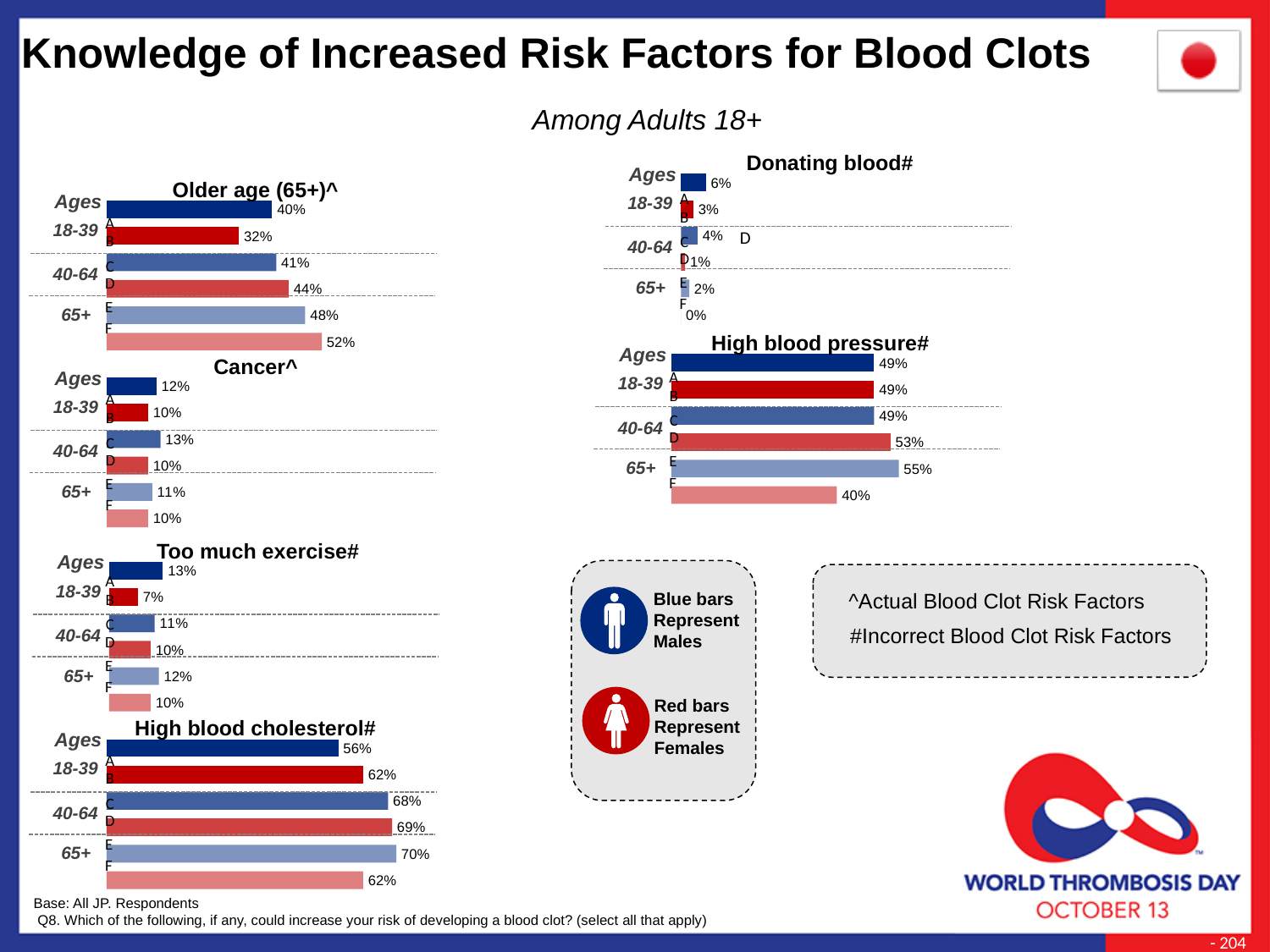
How many bars are shown in the 'Cancer^' chart? 6 What type of chart is used for 'High blood cholesterol#'? Bar chart In the 'Older age (65+)^' chart, what is the value for males aged 18-39? 40% In the 'High blood pressure#' chart, what is the value for females aged 40-64? 53% In the 'High blood cholesterol#' chart, which group has the highest value? Males aged 65+ In the 'High blood cholesterol#' chart, what is the difference between females aged 18-39 and males aged 18-39? 6% In the 'High blood pressure#' chart, which is larger: the value for males aged 65+ or females aged 65+? Males aged 65+ In the 'Cancer^' chart, which group has the highest value? Males aged 40-64 In the 'Too much exercise#' chart, what is the value for females aged 18-39? 7% In the 'Older age (65+)^' chart, what percentage of females aged 65+ identified older age as a risk factor? 52% In the 'Donating blood#' chart, what is the value for males aged 18-39? 6% In the 'Donating blood#' chart, which group has the lowest value? Females aged 65+